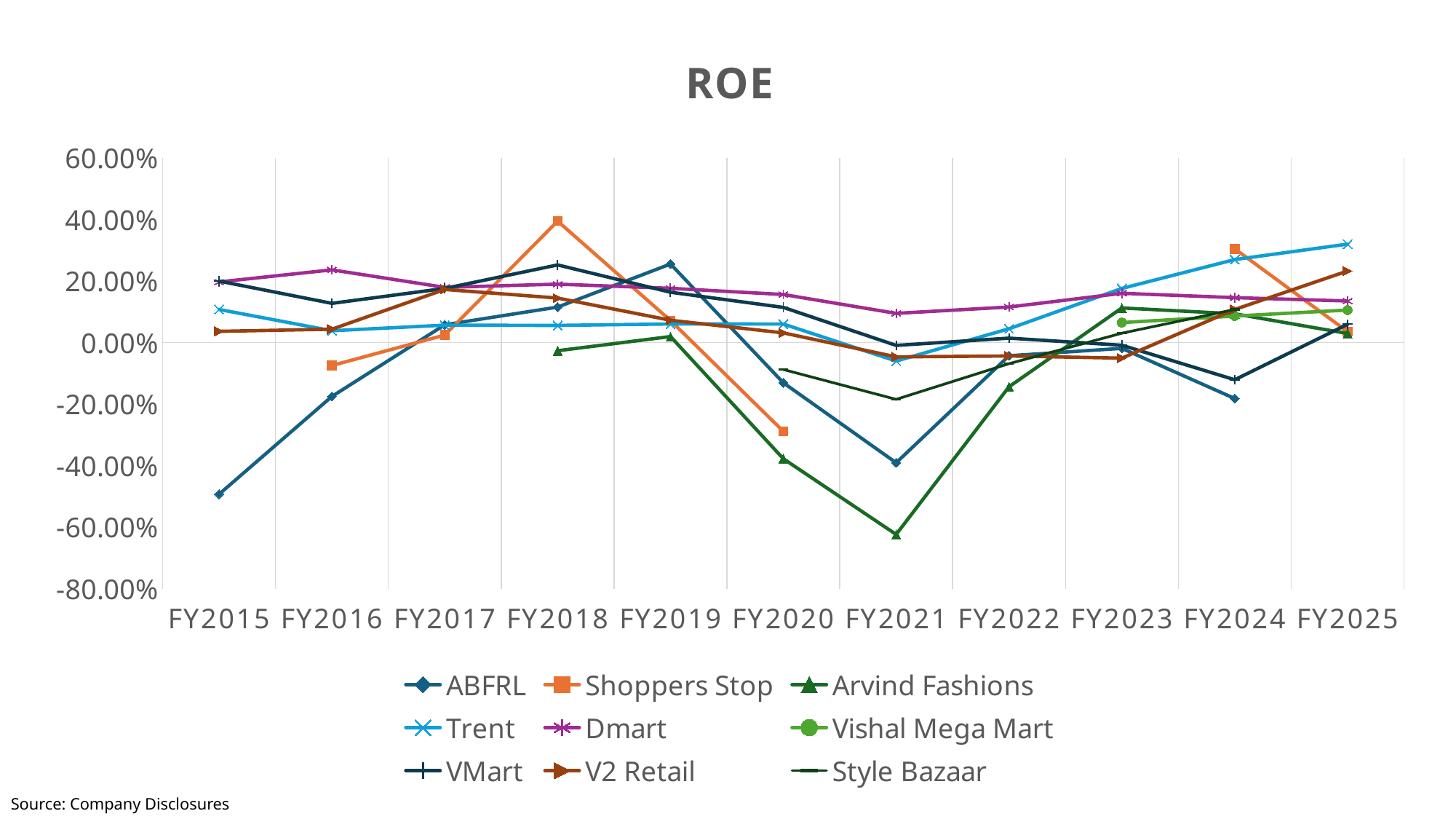
What kind of chart is shown on the slide? line chart Does the value for Trent rise or fall from FY2021 to FY2025? rise How many series does the legend list? 9 Is the value for Shoppers Stop in FY2018 greater or less than 20.00%? greater Is the value for Trent in FY2025 greater or less than 20.00%? greater Which series has the lowest value in FY2021? Arvind Fashions Which series has the highest value in FY2025? Trent What is the title of the chart? ROE In FY2015, which is larger: the value for Dmart or the value for ABFRL? Dmart Is the value for Arvind Fashions in FY2021 greater or less than -40.00%? less How many fiscal years are shown on the x axis? 11